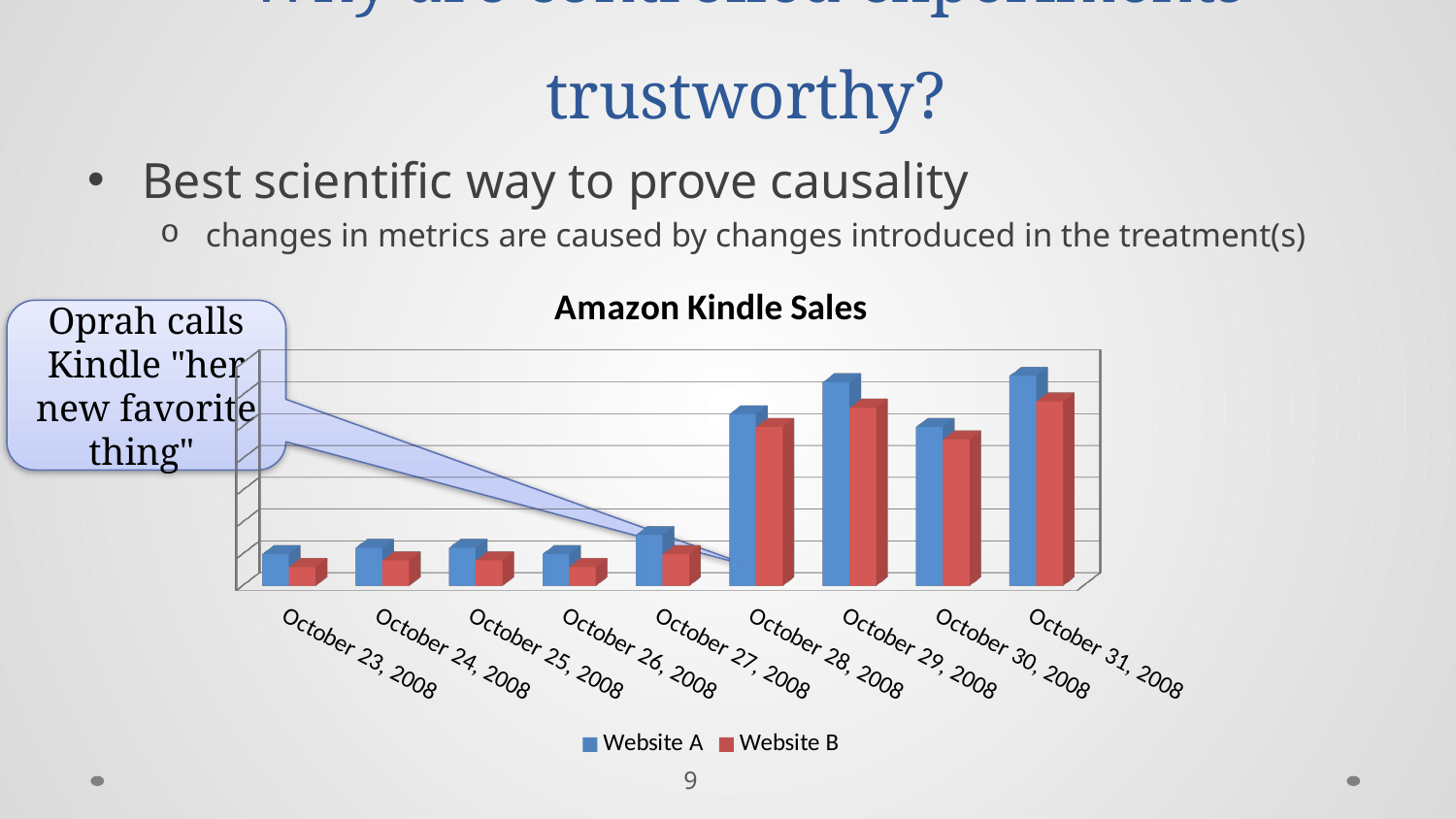
For Website B, is the value for October 31, 2008 larger or smaller than the value for October 30, 2008? Larger What are the two series named in the legend? Website A and Website B What type of chart is shown on the slide? Bar chart How many dates are shown on the x axis of the chart? 9 What is the title of the chart? Amazon Kindle Sales How many series does the legend list? 2 Which date is the last category on the x axis? October 31, 2008 For Website A, is the bar for October 28, 2008 higher or lower than the bar for October 27, 2008? Higher Which date is the first category on the x axis? October 23, 2008 Do the Website A values for October 23 through October 26, 2008 stay low or rise sharply compared with the later dates? Stay low For Website A, which is larger: the value for October 29, 2008 or October 30, 2008? October 29, 2008